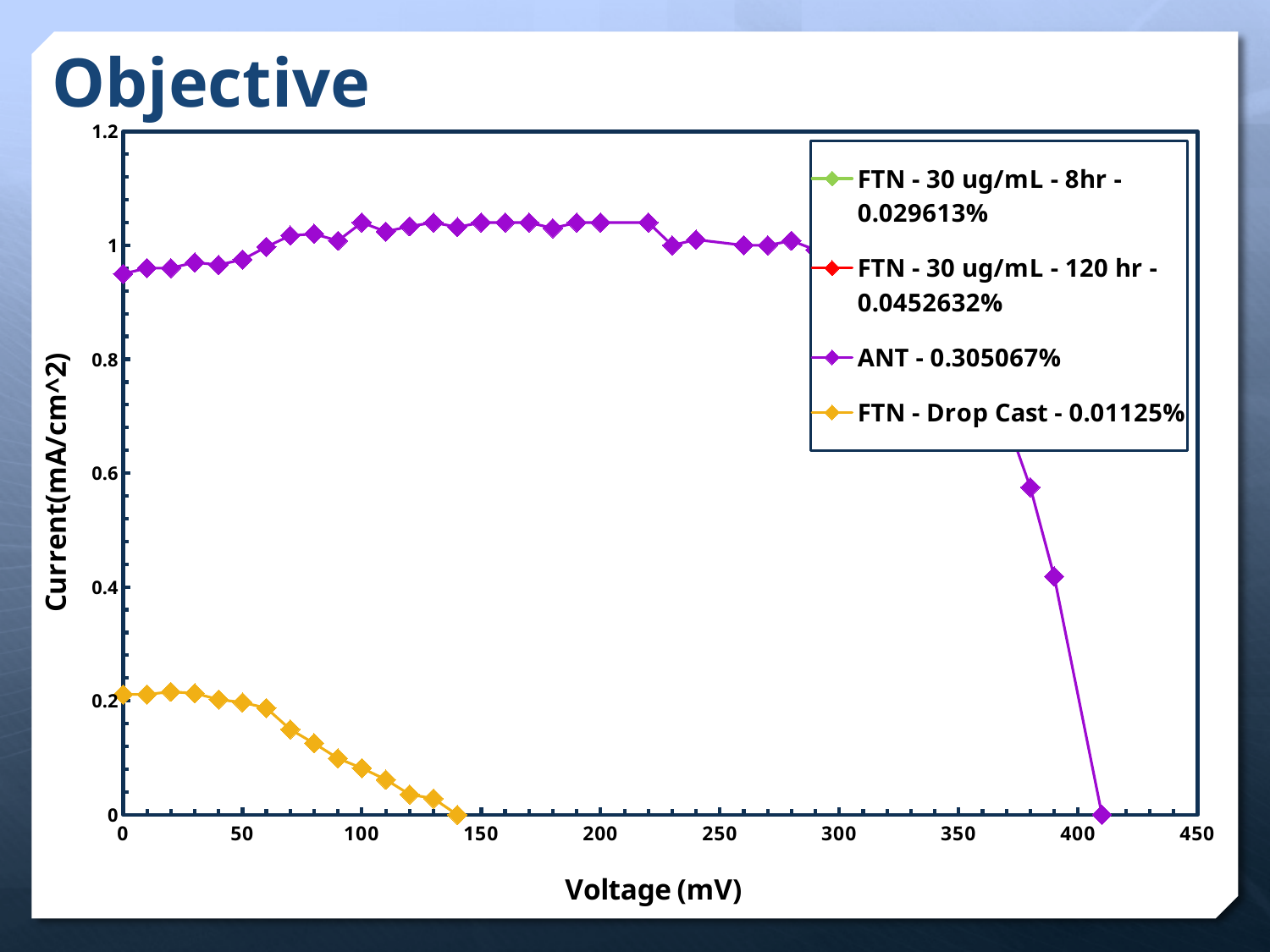
At 100 mV, which series has the higher current: ANT or FTN - Drop Cast? ANT What percentage is given in the legend entry for the ANT series? 0.305067% How many series does the legend list? 4 What kind of chart is shown on the slide? line chart Is the current for the FTN - Drop Cast series at 0 mV greater or less than 0.4? less Which plotted series reaches the highest current on the chart? ANT - 0.305067% Is the current for the ANT series at 200 mV greater or less than 0.8? greater Is the current for the ANT series at 0 mV greater or less than 0.8? greater What is the lowest current value reached by the ANT series? 0 What is the title of the x axis? Voltage (mV) Does the current for the FTN - Drop Cast series rise or fall as voltage increases? fall